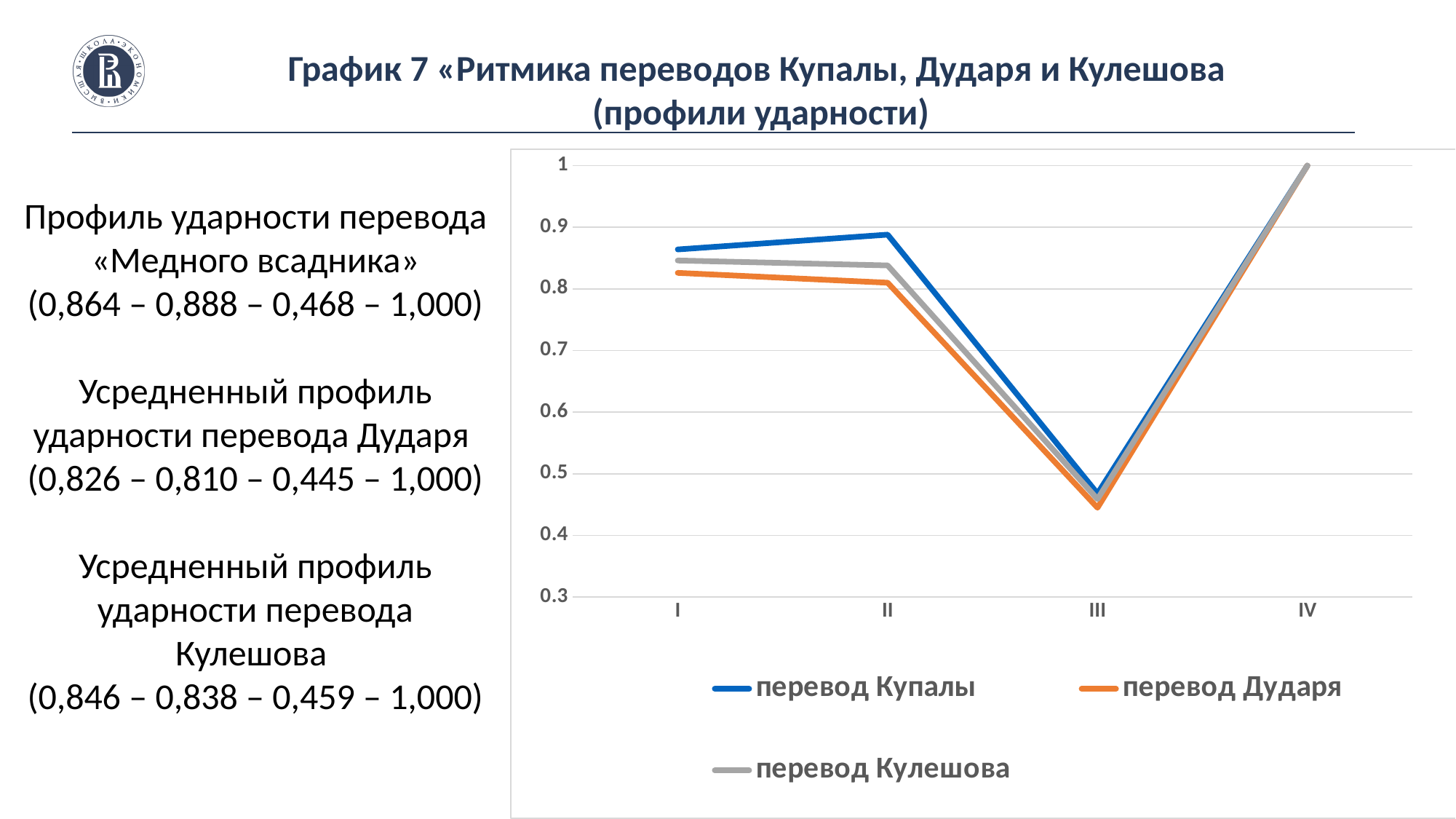
Is the value for перевод Купалы at position II greater or less than 0.8? greater Is the value for перевод Дударя at position III greater or less than 0.5? less How many series does the chart legend list? 3 Do the values for all three series rise or fall from position III to position IV? rise At which position does перевод Дударя reach its lowest value? III What kind of chart is shown on the slide? line chart At position II, which series has the higher value: перевод Купалы or перевод Дударя? перевод Купалы How many points are plotted along the x axis for each series? 4 At which position does перевод Кулешова reach its highest value? IV What is the value for перевод Купалы at position IV? 1 Do the values for all three series rise or fall from position II to position III? fall What colour is the line for перевод Дударя in the legend? orange